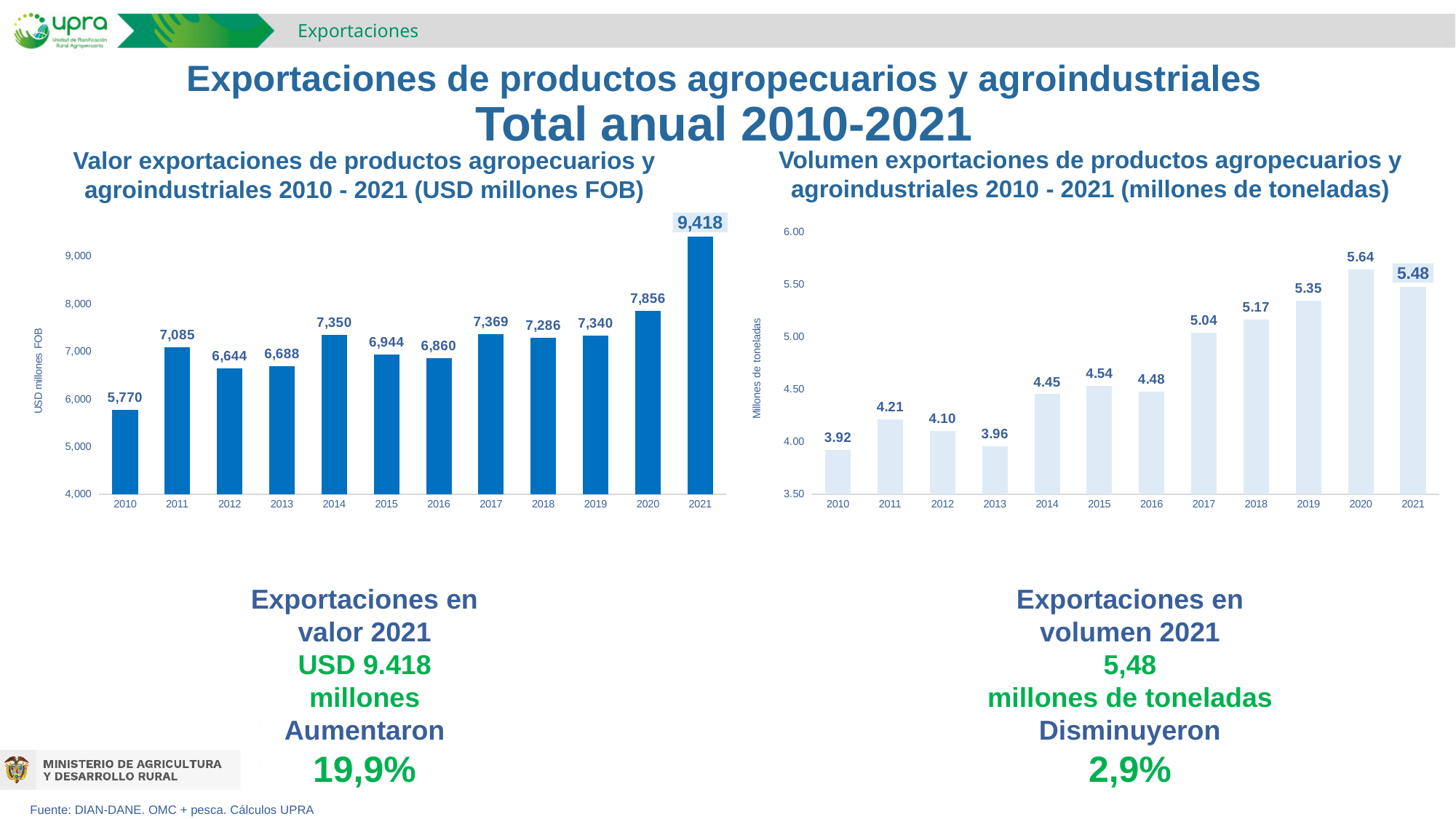
In the left chart (Valor exportaciones), what is the difference between the 2021 value and the 2020 value? 1,562 In the right chart (Volumen exportaciones), which year has the larger value, 2015 or 2016? 2015 In the right chart (Volumen exportaciones), which year has the lowest value? 2010 In the right chart (Volumen exportaciones, millones de toneladas), what is the value for 2017? 5.04 In the left chart (Valor exportaciones), which year has the highest value? 2021 In the left chart (Valor exportaciones), which year has the larger value, 2012 or 2013? 2013 In the left chart (Valor exportaciones, USD millones FOB), what is the value for 2014? 7,350 In the right chart (Volumen exportaciones), what is the difference between the 2020 value and the 2021 value? 0.16 In the left chart (Valor exportaciones), is the value for 2010 greater or less than 6,000? less What kind of chart is the left chart (Valor exportaciones)? Bar chart In the right chart (Volumen exportaciones), do the values generally rise or fall from 2016 to 2020? Rise How many years are plotted in the right chart (Volumen exportaciones)? 12